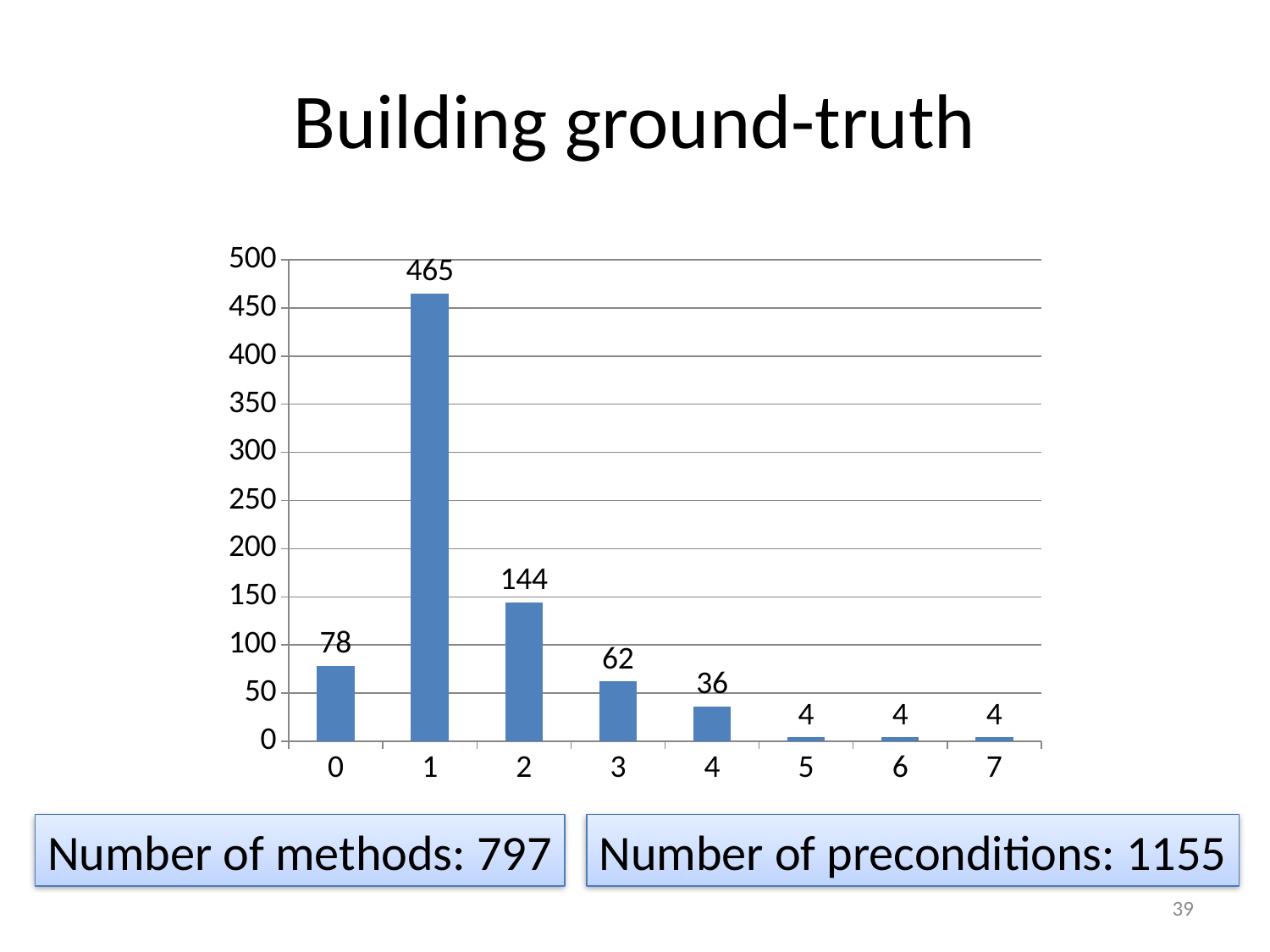
How many categories are shown on the x axis? 8 What is the title of the slide containing the chart? Building ground-truth What is the difference between the values for category 0 and category 3? 16 What is the value for category 1? 465 What is the value for category 4? 36 Which category has the highest value? 1 What is the difference between the values for category 1 and category 2? 321 Which is larger, the value for category 0 or the value for category 3? category 0 Do the values rise or fall along the x axis from category 1 to category 5? fall What kind of chart is shown on the slide? bar chart What is the value for category 2? 144 What is the value for category 0? 78